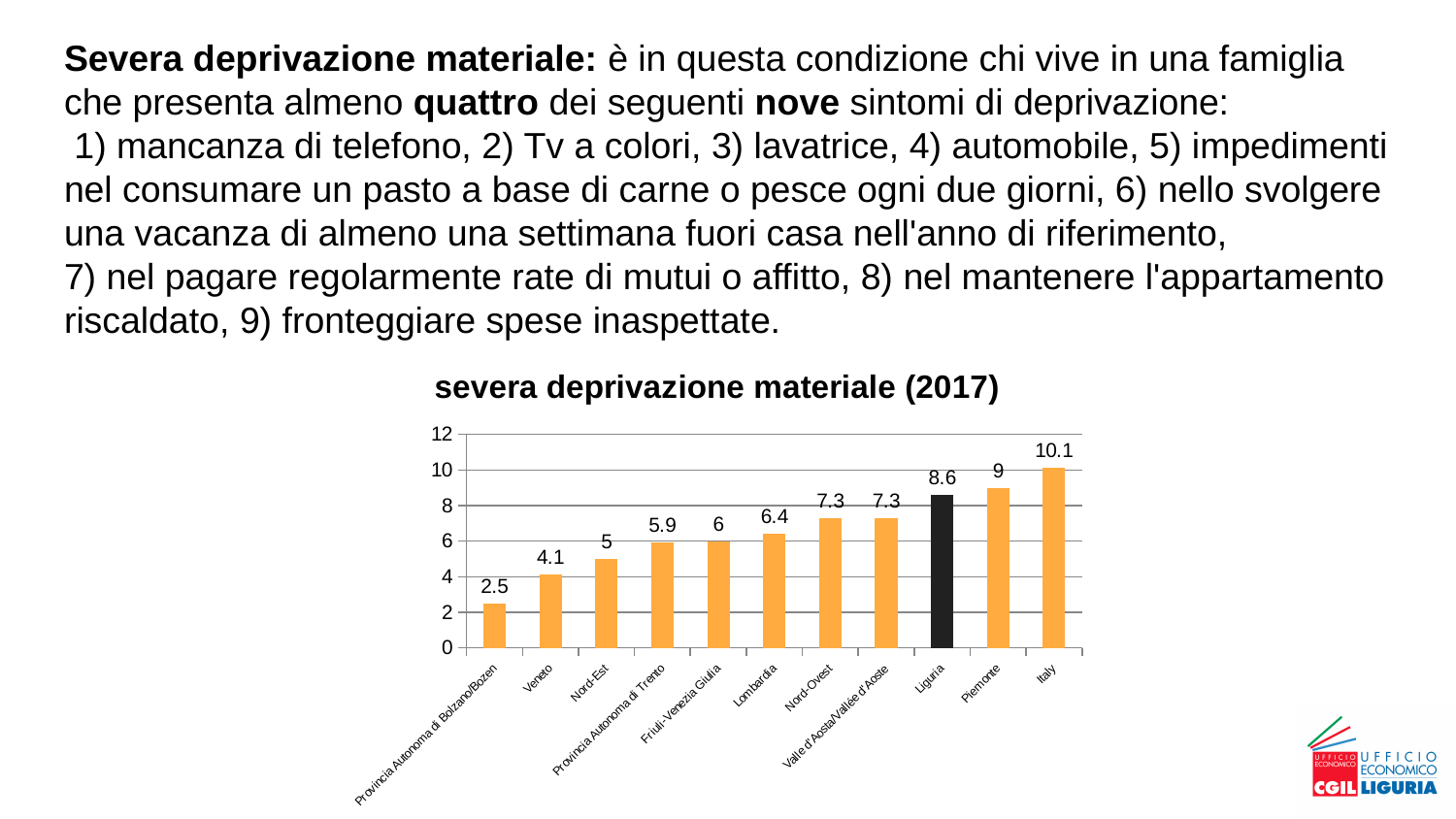
Which category has the highest value in the chart? Italy What is the value for Liguria in the chart 'severa deprivazione materiale (2017)'? 8.6 How many categories are shown in the chart? 11 What is the value for Veneto in the chart? 4.1 What kind of chart is shown on the slide? bar chart Which is larger, the value for Lombardia or the value for Nord-Est? Lombardia Which bar in the chart is coloured differently (dark) from the others? Liguria Which category has the lowest value in the chart? Provincia Autonoma di Bolzano/Bozen Is the value for Piemonte greater or less than 8? greater What is the difference between the values for Piemonte and Veneto? 4.9 What is the value for Italy in the chart? 10.1 What is the difference between the values for Italy and Liguria? 1.5